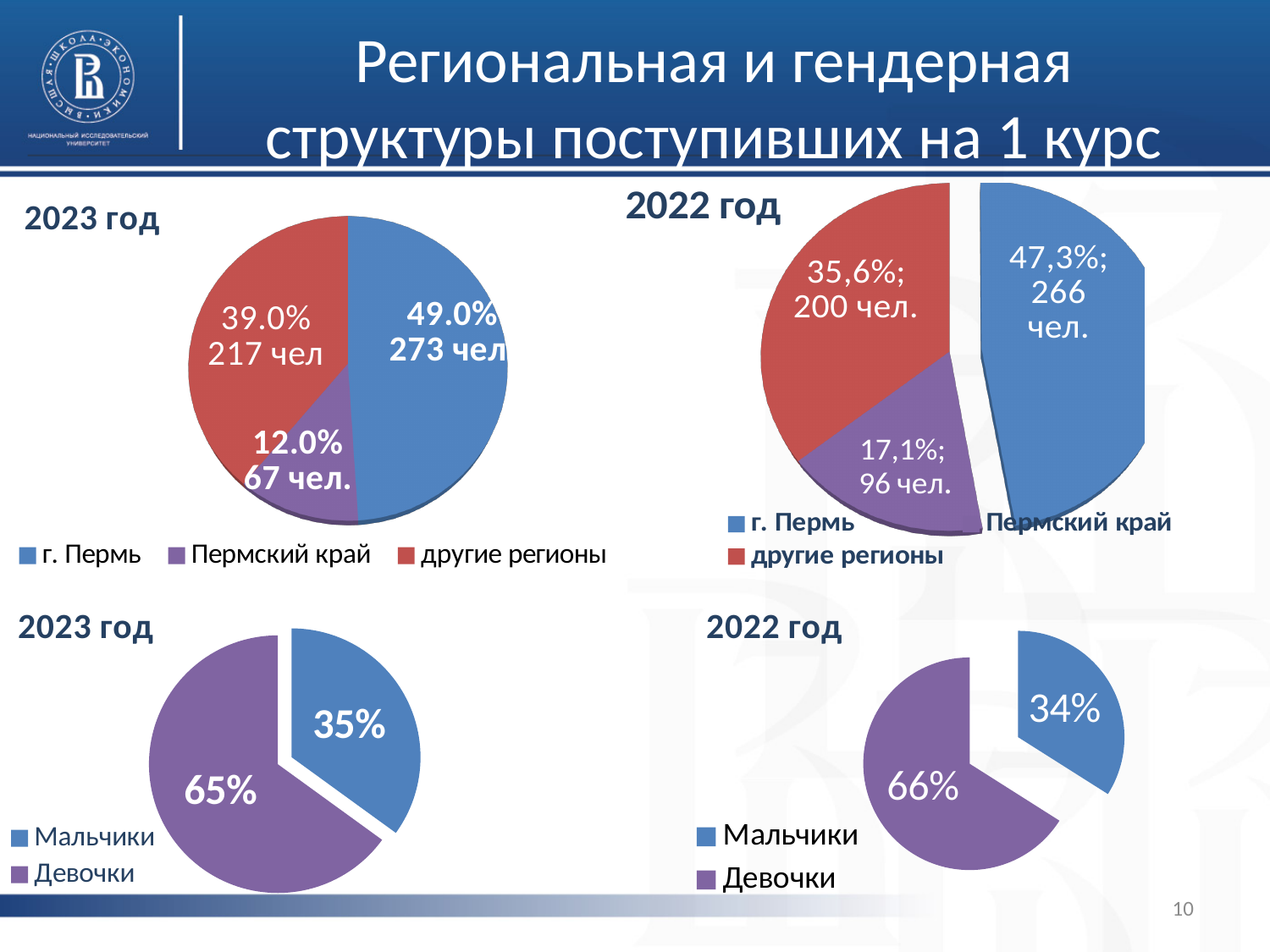
In the top-right pie chart (2022 год, regional structure), which category has the smallest share? Пермский край In the top-right pie chart (2022 год, regional structure), which is larger: the share for г. Пермь or the share for другие регионы? г. Пермь In the top-left pie chart (2023 год, regional structure), how many people are shown for Пермский край? 67 чел. In the bottom-left pie chart (2023 год, gender structure), what share is shown for Девочки? 65% In the top-left pie chart (2023 год, regional structure), what share is shown for г. Пермь? 49.0% In the top-right pie chart (2022 год, regional structure), how many people are shown for другие регионы? 200 чел. In the top-left pie chart (2023 год, regional structure), which category has the largest share? г. Пермь In the bottom-right pie chart (2022 год, gender structure), what share is shown for Мальчики? 34% What type of chart is used in the bottom-right chart (2022 год, gender structure)? Pie chart In the top-right pie chart (2022 год, regional structure), what share is shown for Пермский край? 17,1% In the top-left pie chart (2023 год, regional structure), what is the difference in number of people between г. Пермь and другие регионы? 56 чел. How many categories does the legend of the top-left pie chart (2023 год, regional structure) list? 3